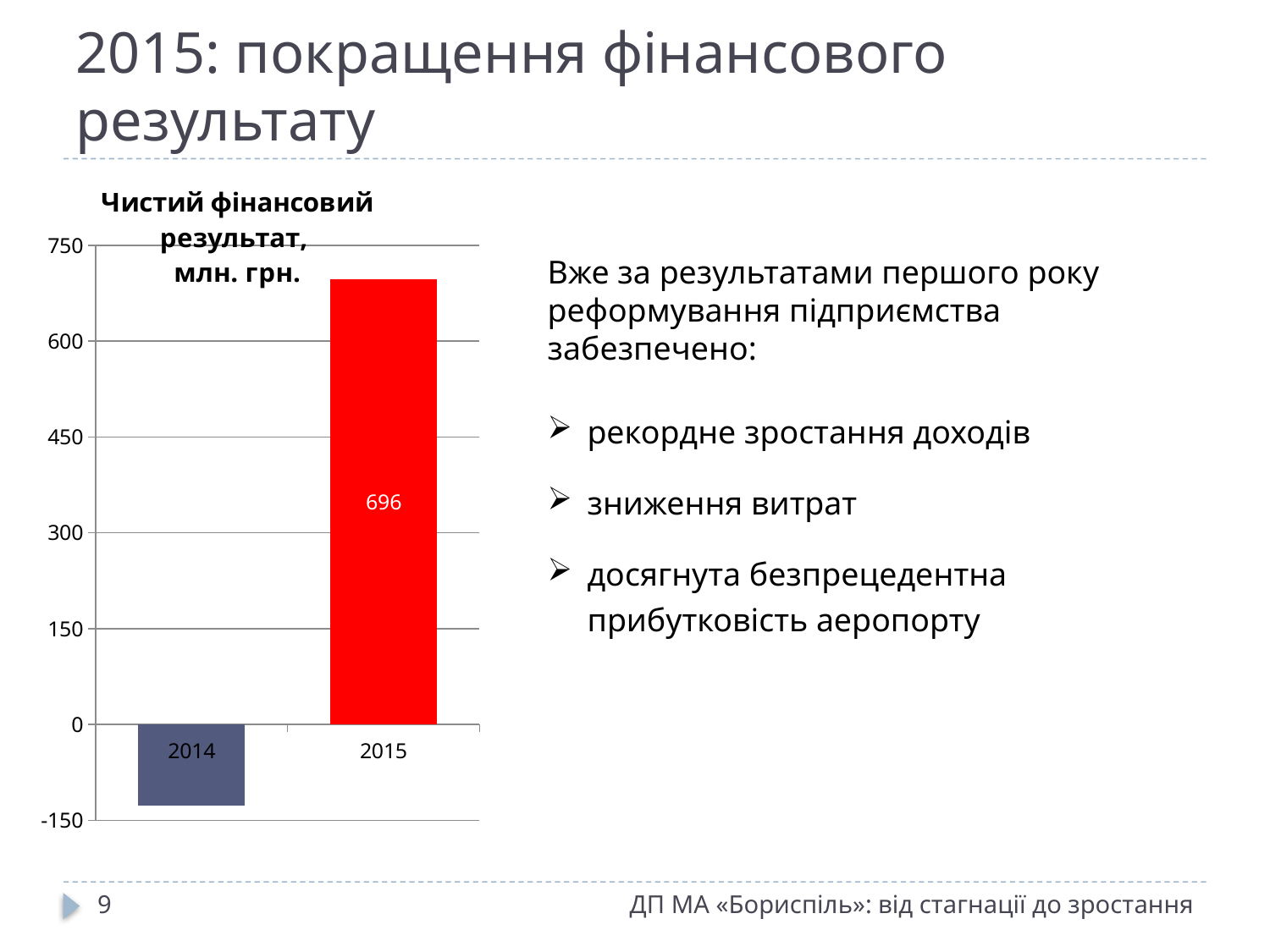
How many years are shown in the chart? 2 Which year has the highest value in the chart? 2015 What kind of chart is shown on the slide? bar chart What is the title of the chart? Чистий фінансовий результат, млн. грн. What colour is the bar for 2015? red Is the value for 2014 greater or less than -150? greater Which year has the lowest value in the chart? 2014 Is the value for 2014 greater or less than 0? less What is the value for 2015 in the chart? 696 Is the value for 2015 greater or less than 600? greater Does the value rise or fall from 2014 to 2015? rise Which is larger, the value for 2014 or the value for 2015? 2015